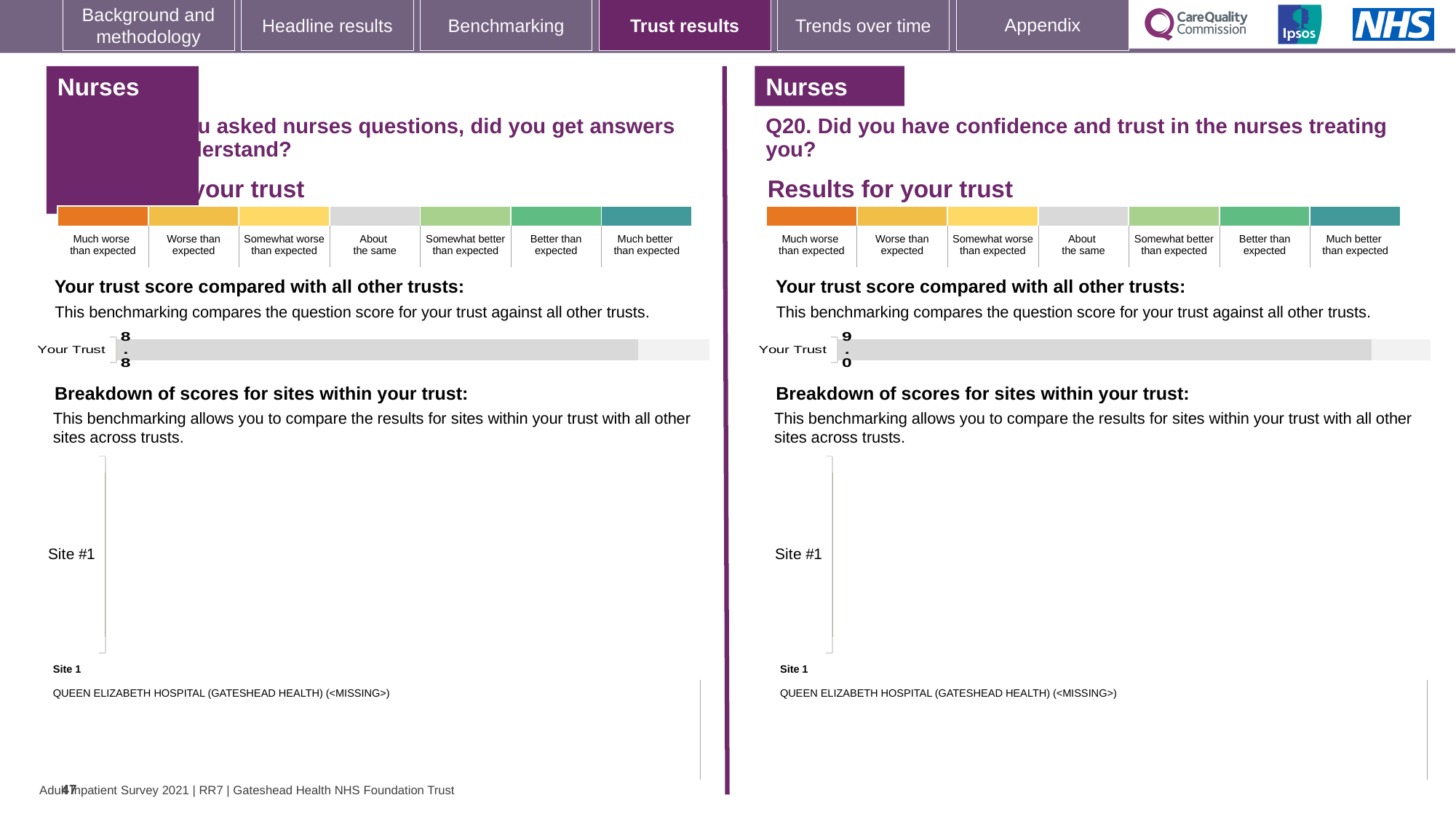
Is the Your Trust score in the right panel (Q20) greater or less than 8.8? greater How many colour bands are shown in the 'Results for your trust' key in the right panel (Q20)? 7 In the right panel (Q20), what is the score shown for Your Trust in the 'Your trust score compared with all other trusts' chart? 9.0 Which panel shows the higher Your Trust score: the left panel or the right panel (Q20)? The right panel (Q20) In the right panel (Q20), how many categories are plotted in the 'Your trust score compared with all other trusts' chart? 1 In the right panel (Q20), how many sites are listed in the 'Breakdown of scores for sites within your trust' chart? 1 In the left panel, what is the score shown for Your Trust in the 'Your trust score compared with all other trusts' chart? 8.8 In the right panel (Q20), which hospital is listed as Site 1? QUEEN ELIZABETH HOSPITAL (GATESHEAD HEALTH) What is the difference between the Your Trust score in the right panel (Q20) and the Your Trust score in the left panel? 0.2 In the left panel, how many sites are listed in the 'Breakdown of scores for sites within your trust' chart? 1 What kind of chart is used to show the Your Trust score in each panel? Bar chart